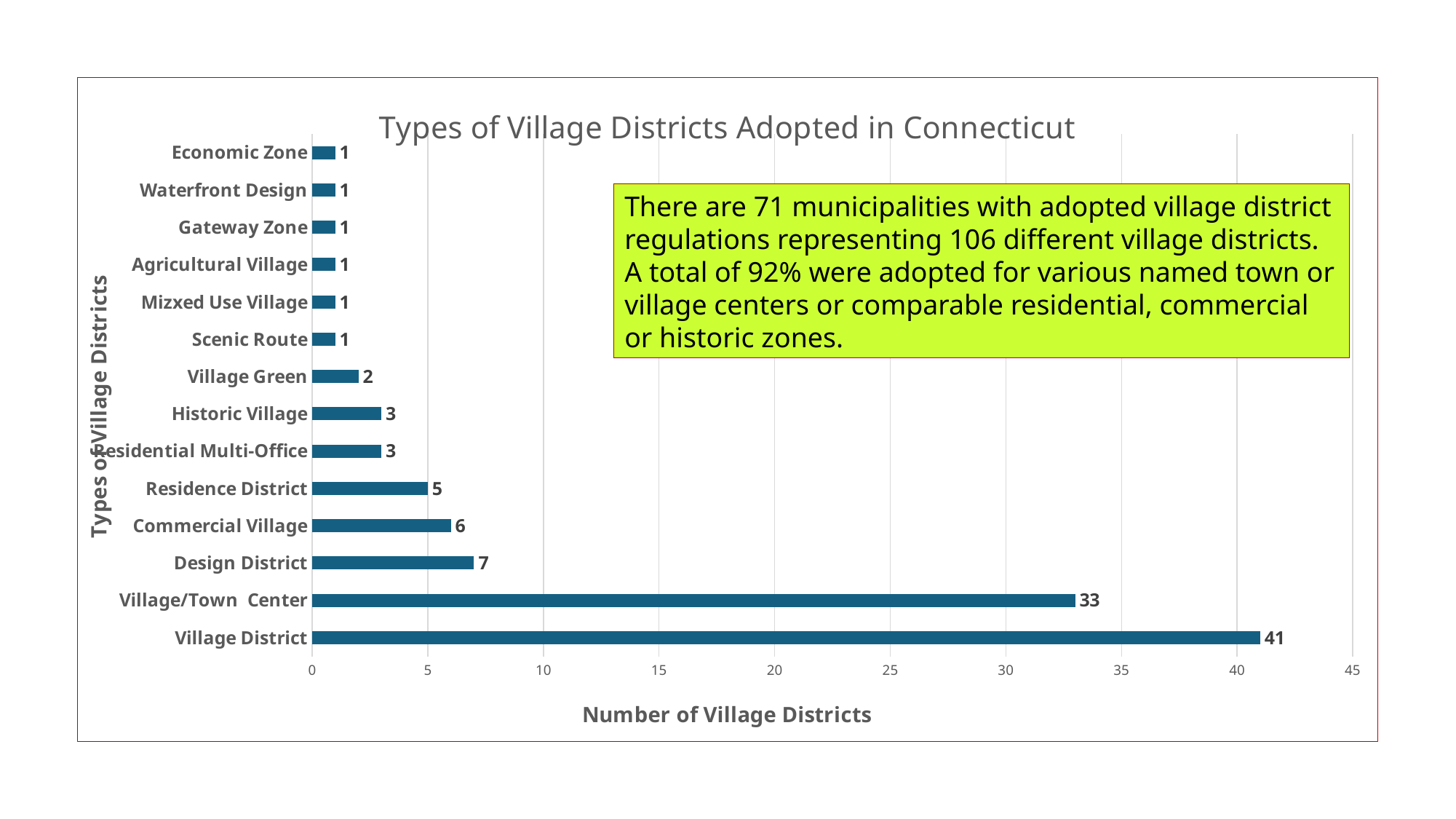
What is the value for Commercial Village? 6 What is the title of the chart? Types of Village Districts Adopted in Connecticut What is the value for Design District? 7 What is the value for Village/Town Center? 33 What is the label of the horizontal axis? Number of Village Districts Which category has the highest number of village districts? Village District What is the difference between the values for Village District and Village/Town Center? 8 Which is larger, the value for Residence District or the value for Historic Village? Residence District Is the value for Village/Town Center greater or less than 30? greater What kind of chart is shown on the slide? Bar chart What is the value for Village District? 41 How many categories are shown on the chart? 14